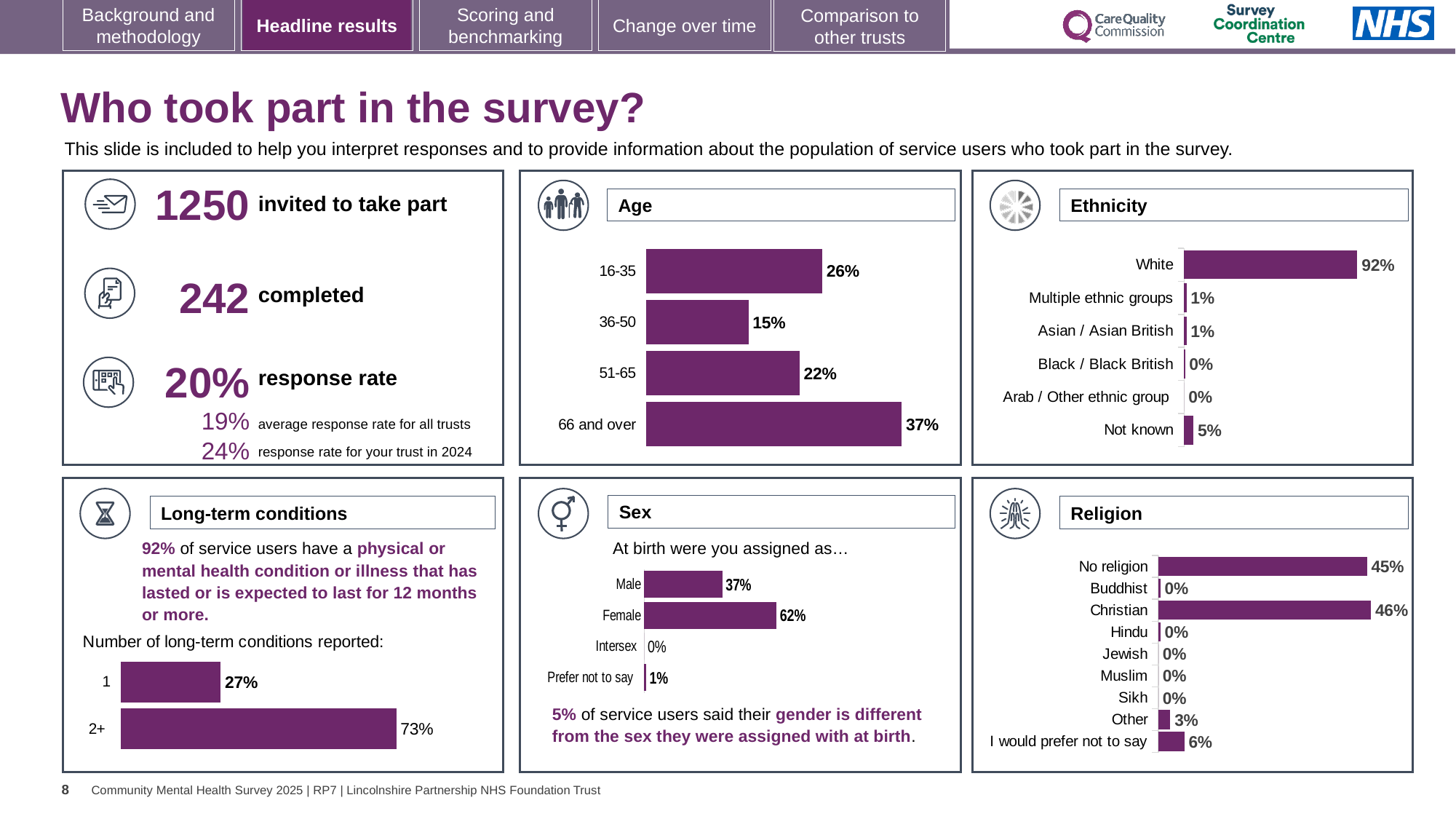
In the Religion chart, which category has the highest percentage? Christian In the Sex chart, which is larger, Male or Female? Female In the Sex chart, what is the difference between the Female and Male percentages? 25% In the Age chart, what percentage of respondents were aged 66 and over? 37% What type of chart is used in the Age panel? Bar chart In the Ethnicity chart, what percentage of respondents were White? 92% In the Age chart, which age group has the lowest percentage? 36-50 In the Ethnicity chart, what percentage is shown for Not known? 5% In the Age chart, what is the difference between the 16-35 and 51-65 percentages? 4% In the Long-term conditions chart, what percentage of service users reported 2+ long-term conditions? 73% In the Ethnicity chart, how many ethnicity categories are shown? 6 In the Religion chart, what percentage of respondents said 'I would prefer not to say'? 6%